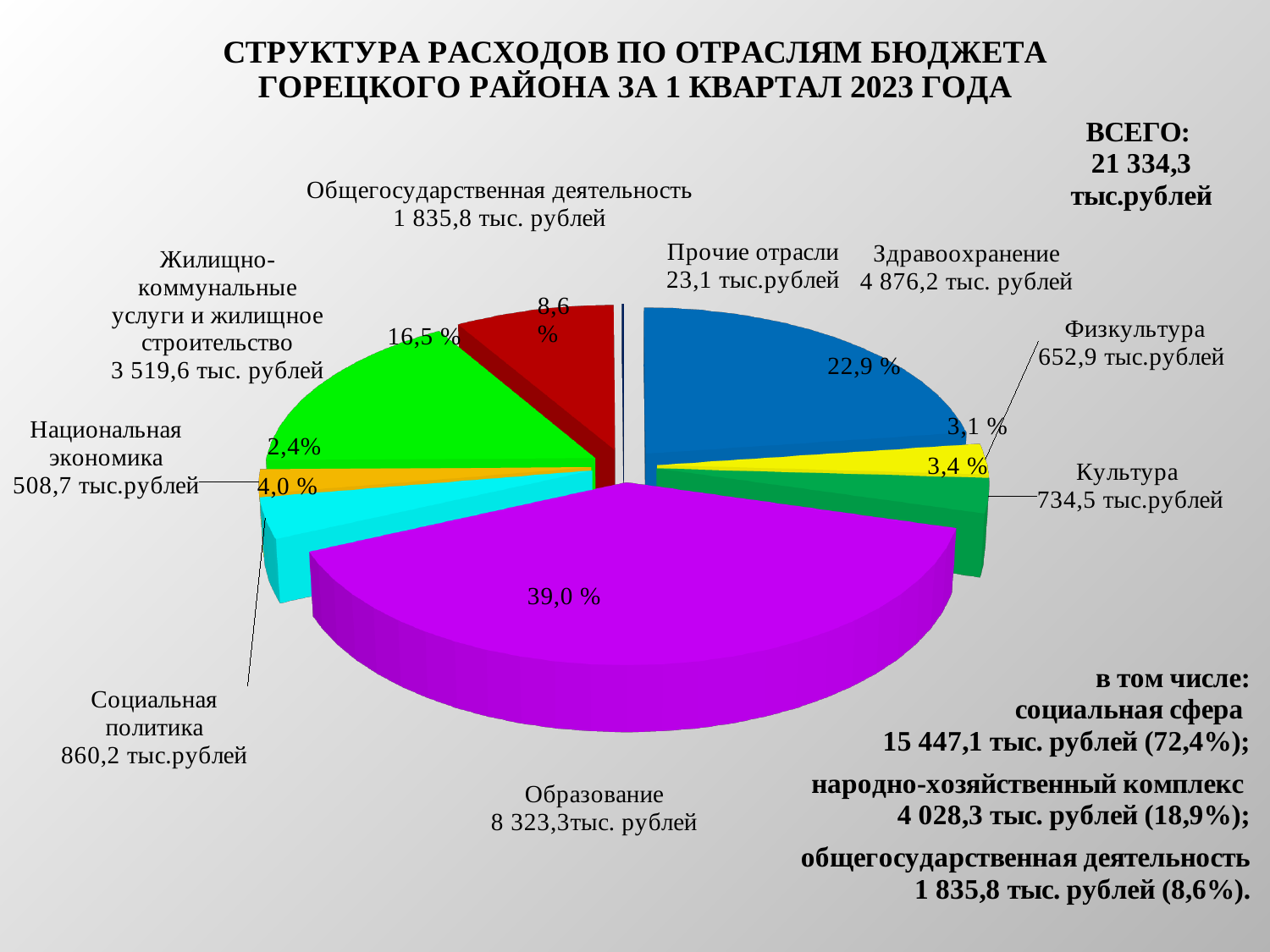
What is the difference in percentage share between Здравоохранение and Общегосударственная деятельность? 14,3 % Which sector has the largest share of expenditures in the pie chart? Образование Which is larger: the expenditure for Культура or for Физкультура? Культура What is the total expenditure (ВСЕГО) shown on the slide? 21 334,3 тыс.рублей What share of the pie does Образование represent? 39,0 % Which sector has the smallest expenditure in the pie chart? Прочие отрасли What is the expenditure for Здравоохранение? 4 876,2 тыс. рублей What kind of chart is shown on the slide? pie chart What is the expenditure for Социальная политика? 860,2 тыс.рублей What share of the pie does Жилищно-коммунальные услуги и жилищное строительство represent? 16,5 % How many sectors are shown in the pie chart? 9 What period does the chart title say the expenditure structure covers? 1 квартал 2023 года